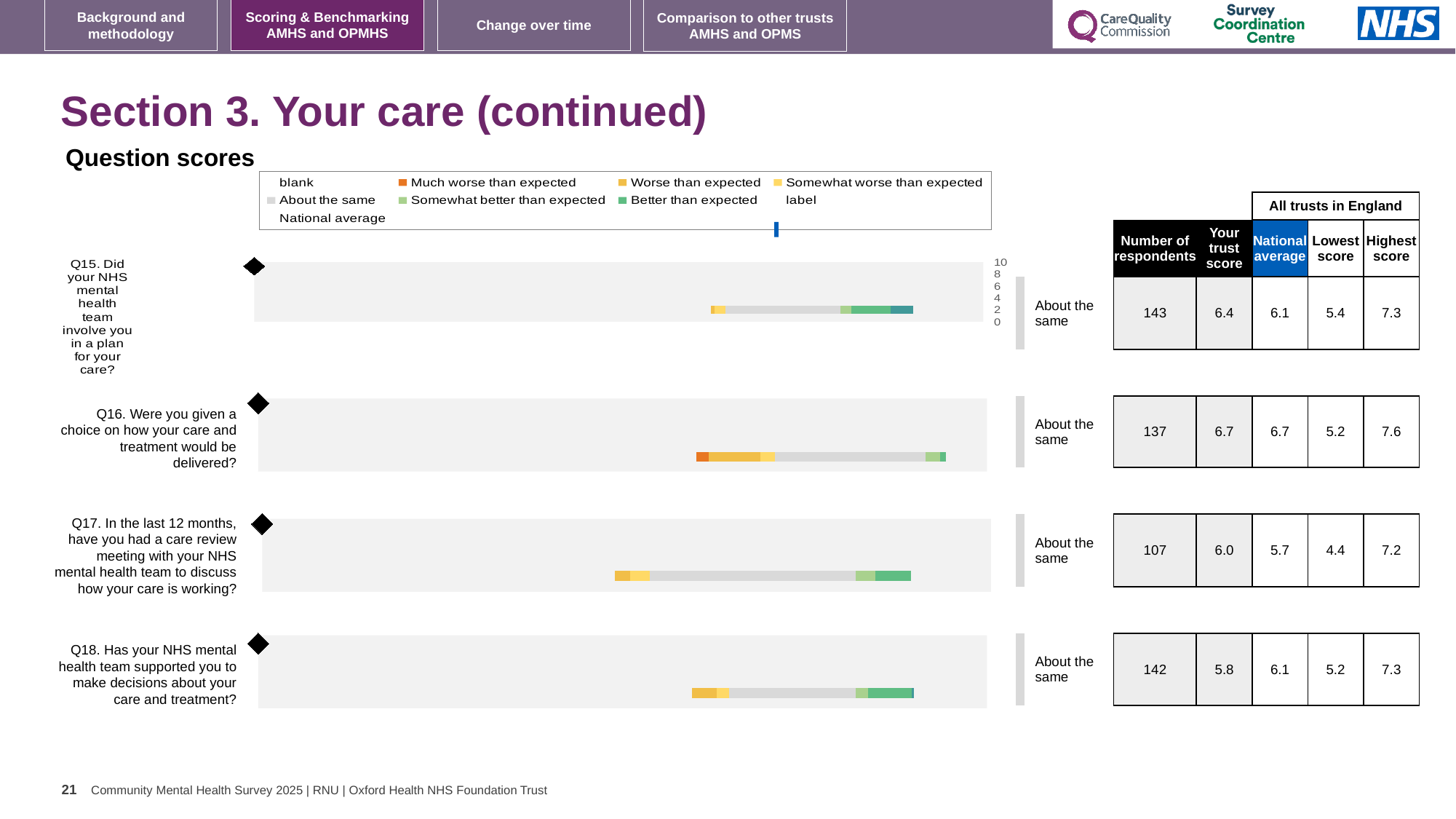
What kind of chart is used to show the question scores? Bar chart Which question has the highest 'Your trust score' on this slide? Q16 For Q15, which is larger: the trust score or the national average? Trust score How many respondents answered Q16 (choice on how your care and treatment would be delivered)? 137 How many survey questions are charted on this slide? 4 Which question has the lowest 'Your trust score' on this slide? Q18 What is the trust score for Q15 (Did your NHS mental health team involve you in a plan for your care?)? 6.4 Which question has the fewest respondents? Q17 What is the difference between the national average and the trust score for Q18? 0.3 What benchmark category label is shown next to the Q17 bar? About the same What is the national average score for Q17 (care review meeting in the last 12 months)? 5.7 What is the highest score across all trusts in England for Q18 (supported to make decisions about your care and treatment)? 7.3